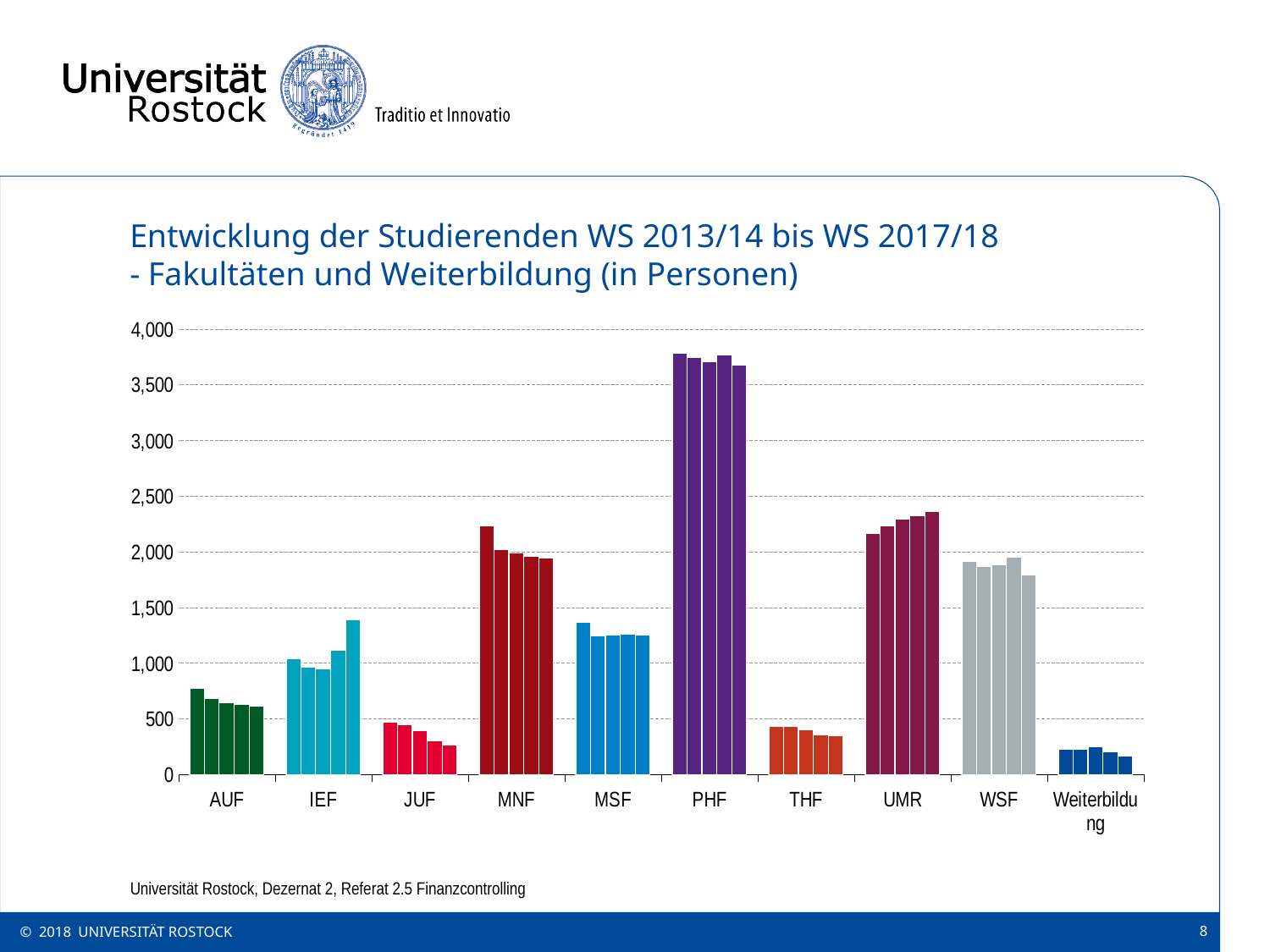
Are the values for WSF greater or less than 2,000? less Do the values for JUF rise or fall from WS 2013/14 to WS 2017/18? fall Which category has the lowest bars? Weiterbildung Are the values for THF greater or less than 500? less How many faculty/category groups are shown along the x axis? 10 Which category has the highest bars? PHF Are the values for UMR greater or less than 2,000? greater How many bars are shown for each category group? 5 Do the values for UMR rise or fall from WS 2013/14 to WS 2017/18? rise What kind of chart is shown on the slide? bar chart Which category has higher values, MNF or MSF? MNF